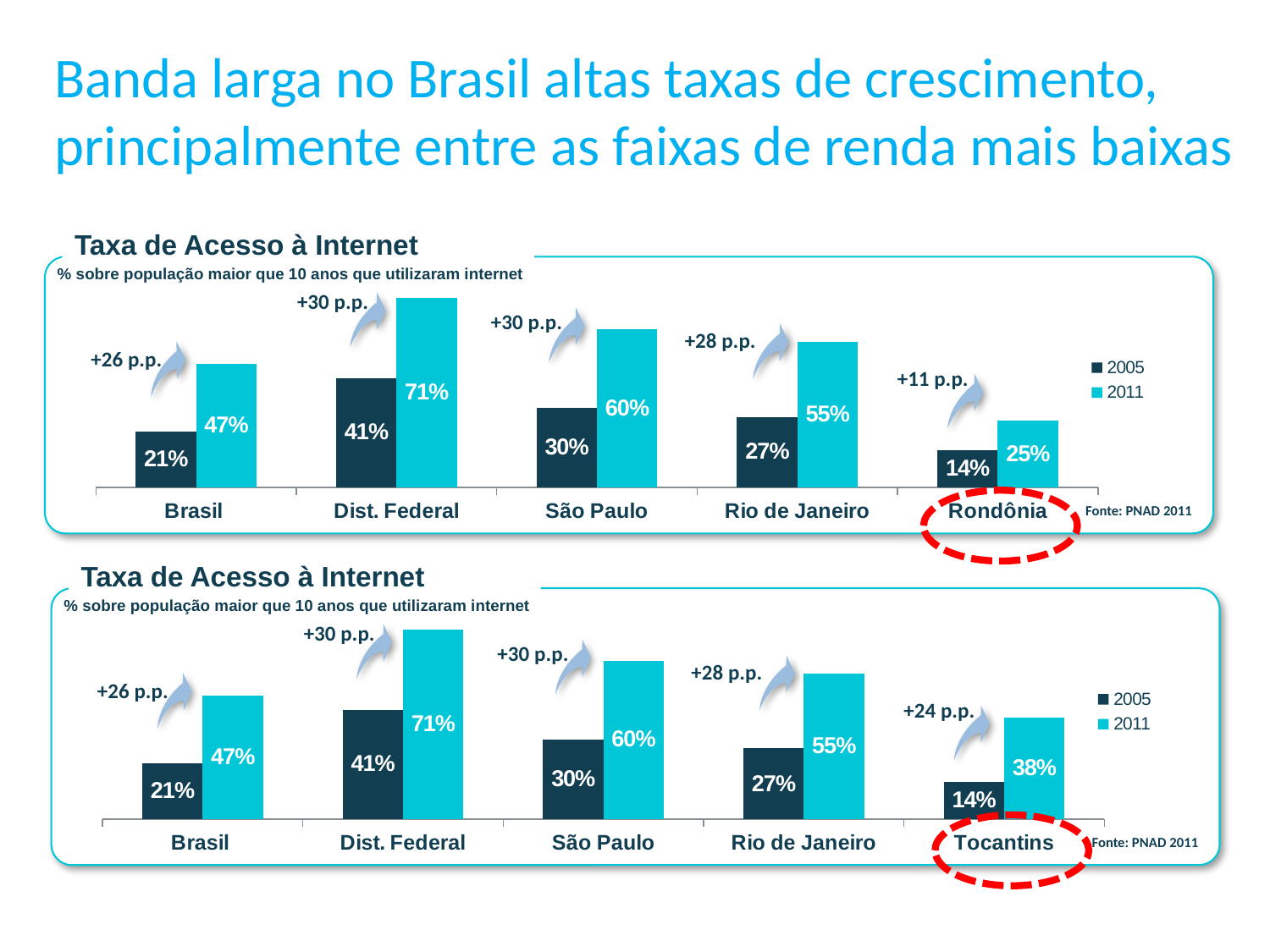
How many series does the legend of the top chart list? 2 What is the source cited below the bottom chart? PNAD 2011 In the top chart, what is the difference between the 2011 and 2005 values for São Paulo? 30 p.p. How many categories are shown on the x axis of the bottom chart? 5 In the bottom chart, what is the difference between the 2011 and 2005 values for Tocantins? 24 p.p. In the top chart, which category has the lowest 2005 value? Rondônia In the top chart, what is the 2011 value for Rondônia? 25% What kind of chart is the top chart? Bar chart In the bottom chart, which category has the highest 2011 value? Dist. Federal In the top chart, what is the 2005 value for Dist. Federal? 41% In the top chart, which is larger: the 2011 value for Rio de Janeiro or the 2011 value for Brasil? Rio de Janeiro In the bottom chart, what is the 2011 value for Tocantins? 38%